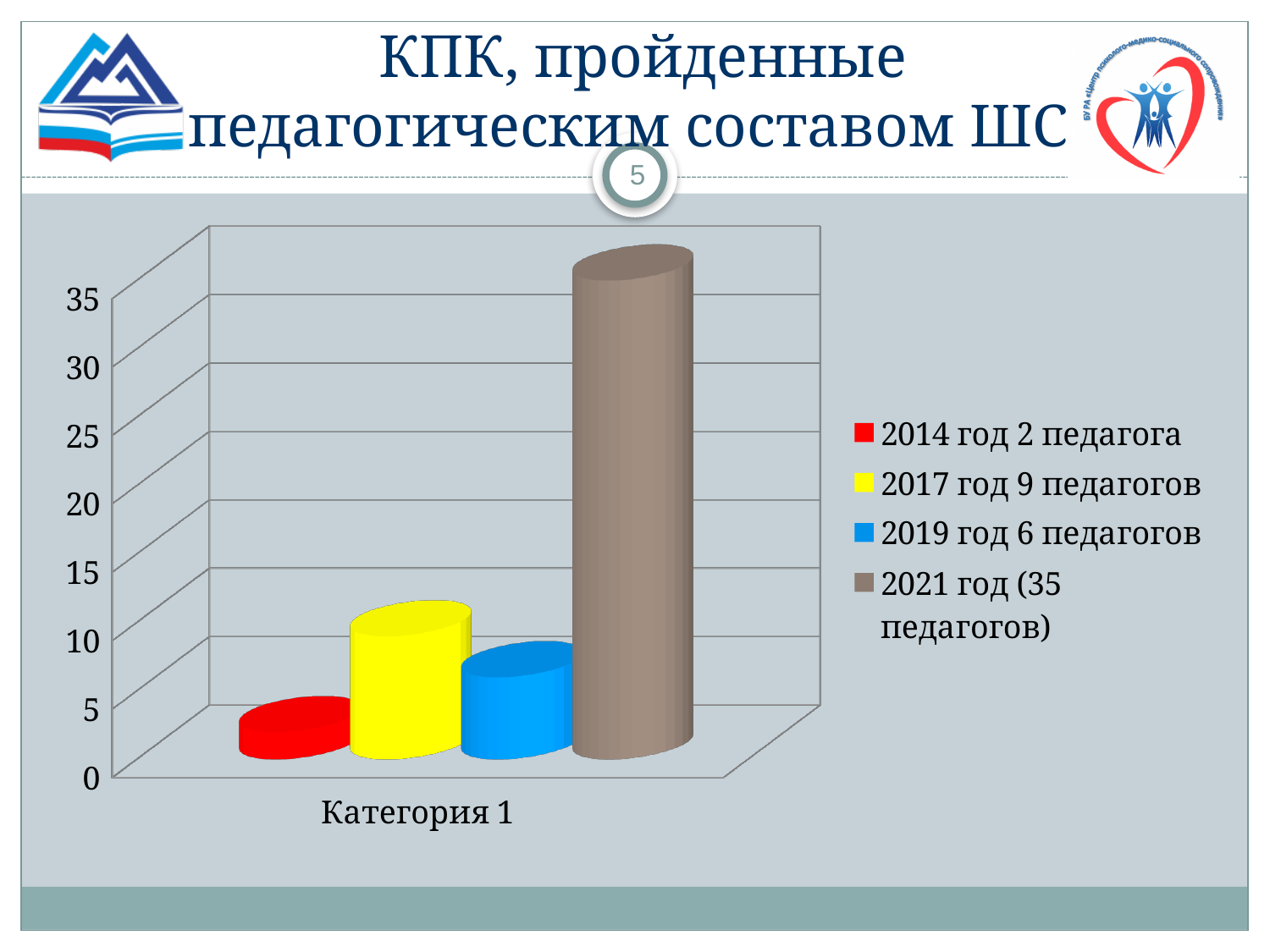
How many categories are shown on the x axis? 1 According to the legend, how many teachers completed courses in 2021? 35 педагогов What is the label of the category on the x axis? Категория 1 Which is larger, the value for 2017 год or for 2019 год? 2017 год Is the value for 2019 год greater or less than 10? less Which year has the highest bar? 2021 год According to the legend, how many teachers completed courses in 2014? 2 педагога How many series does the legend list? 4 Is the value for 2021 год greater or less than 30? greater Which year has the lowest bar? 2014 год What is the difference between the number of teachers in 2021 and in 2017? 26 What kind of chart is shown on the slide? bar chart